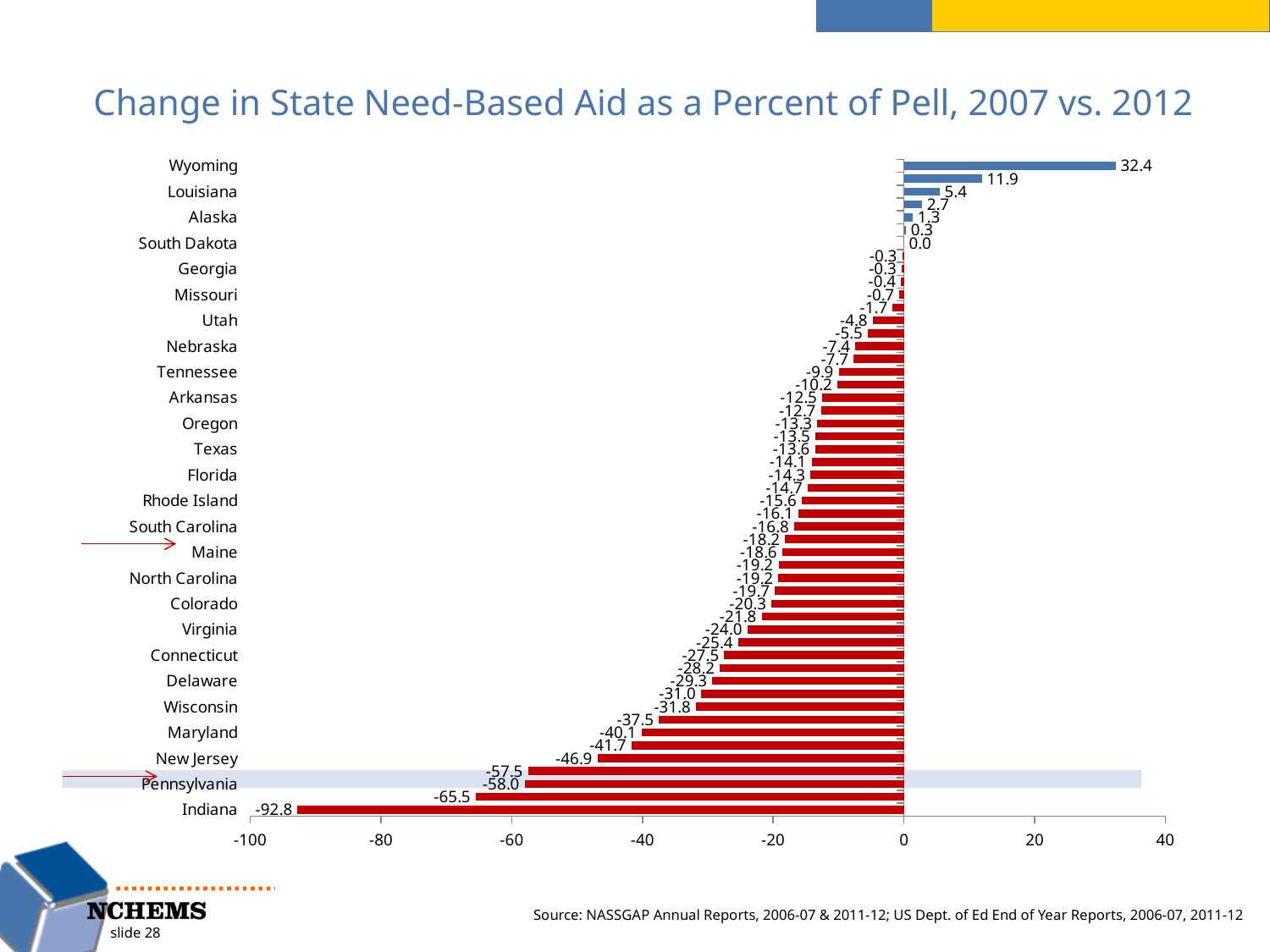
What is the value for Louisiana? 5.4 What is the value for Indiana? -92.8 What is the value for Wyoming? 32.4 Which state has the lowest value in the chart? Indiana What is the value for South Dakota? 0.0 Is the value for Indiana greater or less than -80? less What is the title of the chart? Change in State Need-Based Aid as a Percent of Pell, 2007 vs. 2012 What type of chart is shown on the slide? bar chart What is the difference between the values for Wyoming and Indiana? 125.2 What is the value for Pennsylvania? -58.0 Which state has the highest value in the chart? Wyoming Which has a larger value, New Jersey or Maryland? Maryland